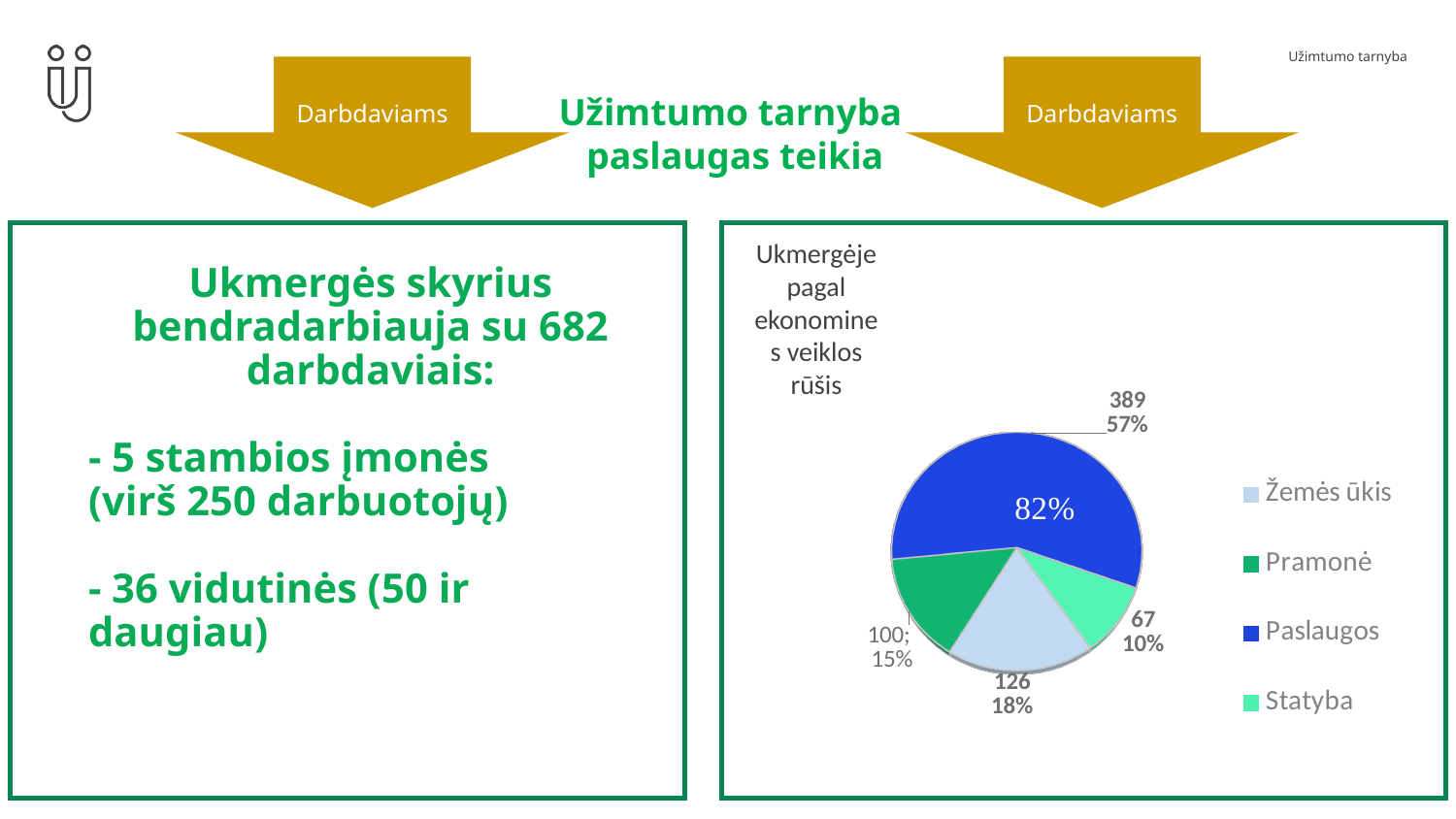
Which category has the smallest slice in the pie chart? Statyba What value is shown for Paslaugos in the pie chart? 389 How many categories does the legend of the pie chart list? 4 What percentage share does Statyba have in the pie chart? 10% What percentage share does Paslaugos have in the pie chart? 57% Which colour represents Paslaugos in the pie chart? dark blue What is the difference between the values for Paslaugos and Žemės ūkis in the pie chart? 263 What value is shown for Pramonė in the pie chart? 100 Which category has the largest slice in the pie chart? Paslaugos What kind of chart is shown on the slide? pie chart What value is shown for Žemės ūkis in the pie chart? 126 Which is larger in the pie chart, Žemės ūkis or Pramonė? Žemės ūkis